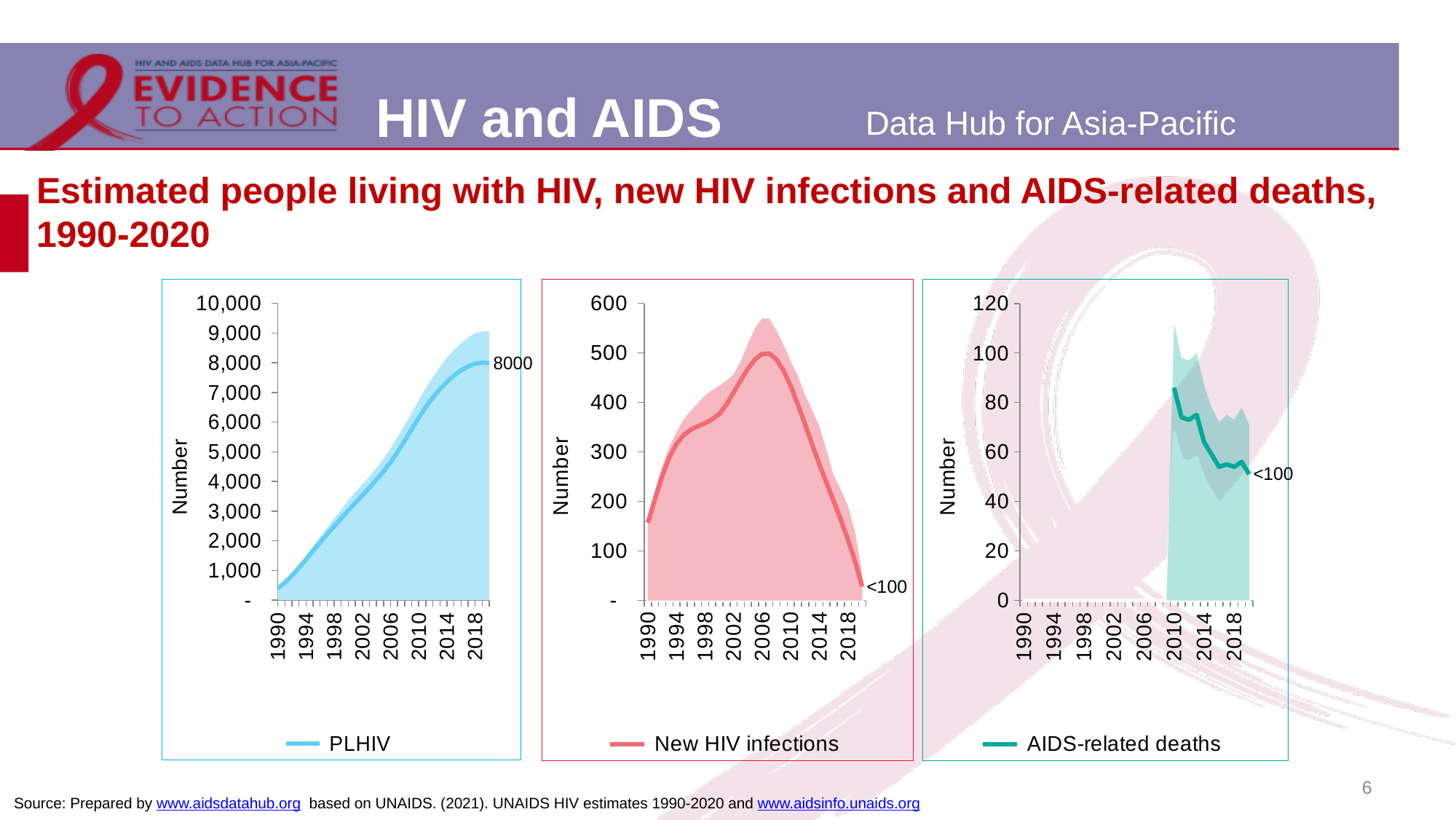
What is the legend entry of the right chart? AIDS-related deaths On the middle chart (New HIV infections), what is the data label shown at the end of the line in 2020? <100 On the middle chart (New HIV infections), is the value for 1990 greater or less than 200? less On the left chart (PLHIV), is the value for 2010 greater or less than 4,000? greater How many series does the legend of the middle chart list? 1 On the middle chart (New HIV infections), is the peak value around 2007 greater or less than 400? greater On the right chart (AIDS-related deaths), does the line rise or fall from 2010 to 2020? fall What type of chart is the left chart (PLHIV)? combination area and line chart (a line with a shaded area band) On the left chart (PLHIV), what is the data label shown at the end of the line in 2020? 8000 On the right chart (AIDS-related deaths), what is the data label shown at the end of the line in 2020? <100 On the left chart (PLHIV), does the line rise or fall from 1990 to 2020? rise